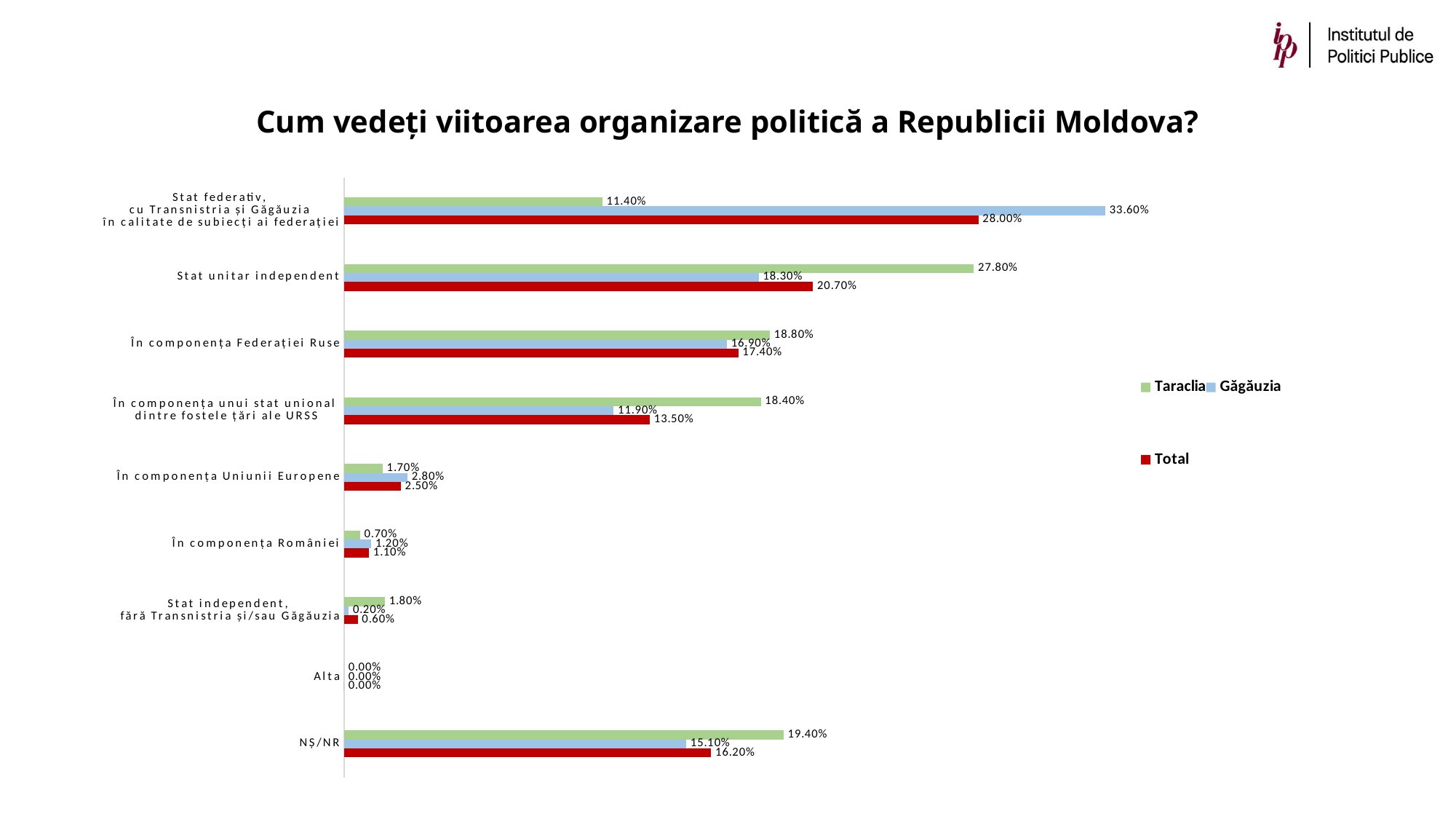
Which category has the lowest Taraclia value? Alta Which category has the highest Total value? Stat federativ, cu Transnistria și Găgăuzia în calitate de subiecți ai federației How many series does the legend list? 3 What is the Găgăuzia value for 'Stat federativ, cu Transnistria și Găgăuzia în calitate de subiecți ai federației'? 33.60% What is the Taraclia value for 'Stat unitar independent'? 27.80% What is the title of the chart? Cum vedeți viitoarea organizare politică a Republicii Moldova? What kind of chart is shown on the slide? Bar chart What is the Găgăuzia value for 'NȘ/NR'? 15.10% How many categories are shown on the chart? 9 What is the difference between the Găgăuzia and Taraclia values for 'Stat federativ, cu Transnistria și Găgăuzia în calitate de subiecți ai federației'? 22.20% What is the Total value for 'În componența Federației Ruse'? 17.40% Which is larger for 'În componența unui stat unional dintre fostele țări ale URSS': the Taraclia value or the Găgăuzia value? Taraclia